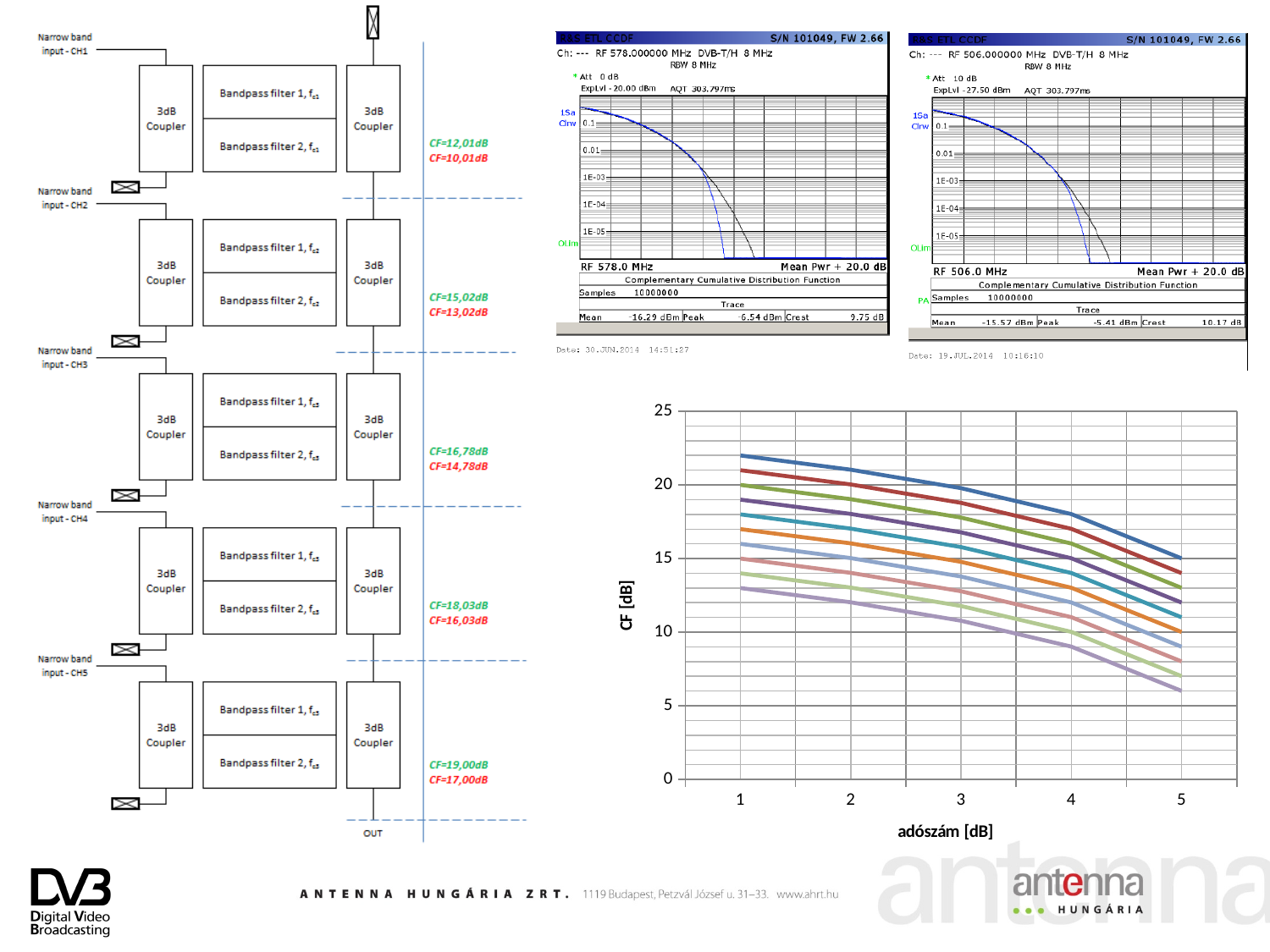
In the bottom-right line chart, what is the label of the vertical axis? CF [dB] Which CCDF screenshot shows the larger Crest value, the left one (RF 578.0 MHz) or the right one (RF 506.0 MHz)? the right one (RF 506.0 MHz) What kind of chart is the chart at the bottom right of the slide (CF [dB] versus adószám [dB])? line chart In the bottom-right line chart, what is the label of the horizontal axis? adószám [dB] In the bottom-right line chart, how many lines are plotted? 10 In the bottom-right line chart, do the lines rise or fall as adószám increases from 1 to 5? fall In the CCDF screenshot on the left (RF 578.0 MHz), what Crest value is shown? 9.75 dB In the CCDF screenshot on the right (RF 506.0 MHz), what Mean value is shown? -15.57 dBm In the bottom-right line chart, is the value of the lowest line at adószám 1 greater or less than 10? greater In the bottom-right line chart, is the value of the lowest line at adószám 5 greater or less than 10? less In the bottom-right line chart, how many points are marked along the horizontal axis? 5 In the bottom-right line chart, is the value of the topmost line at adószám 1 greater or less than 20? greater